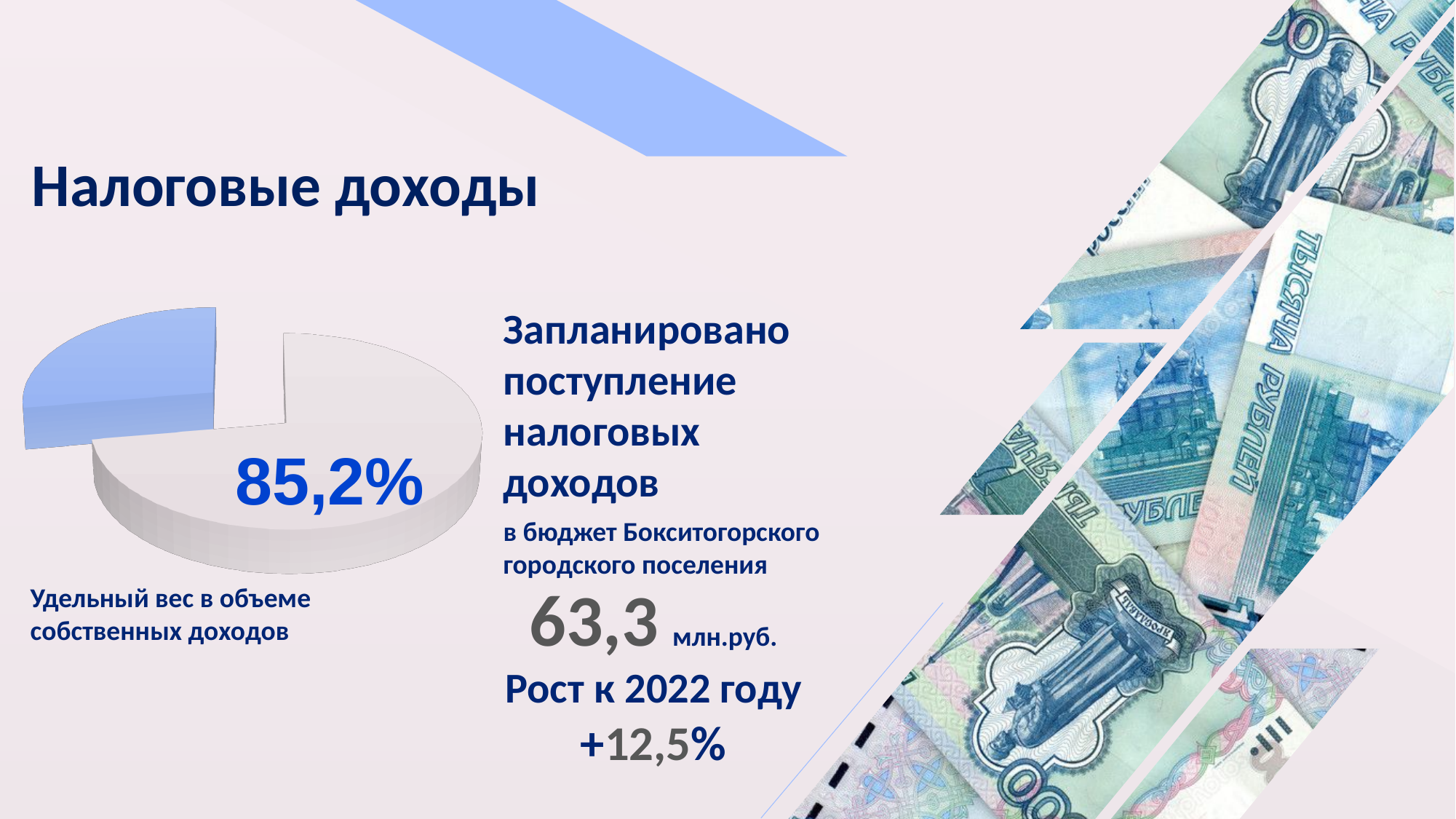
Which slice of the pie chart is the smallest? the blue slice Which slice of the pie chart is larger, the grey one or the blue one? the grey one How many slices does the pie chart have? 2 What caption is written below the pie chart? Удельный вес в объеме собственных доходов What colour is the slice labelled 85,2%? grey What value is printed on the large slice of the pie chart? 85,2% What share of the pie does the labelled slice represent? 85,2% What kind of chart is shown on the slide? pie chart